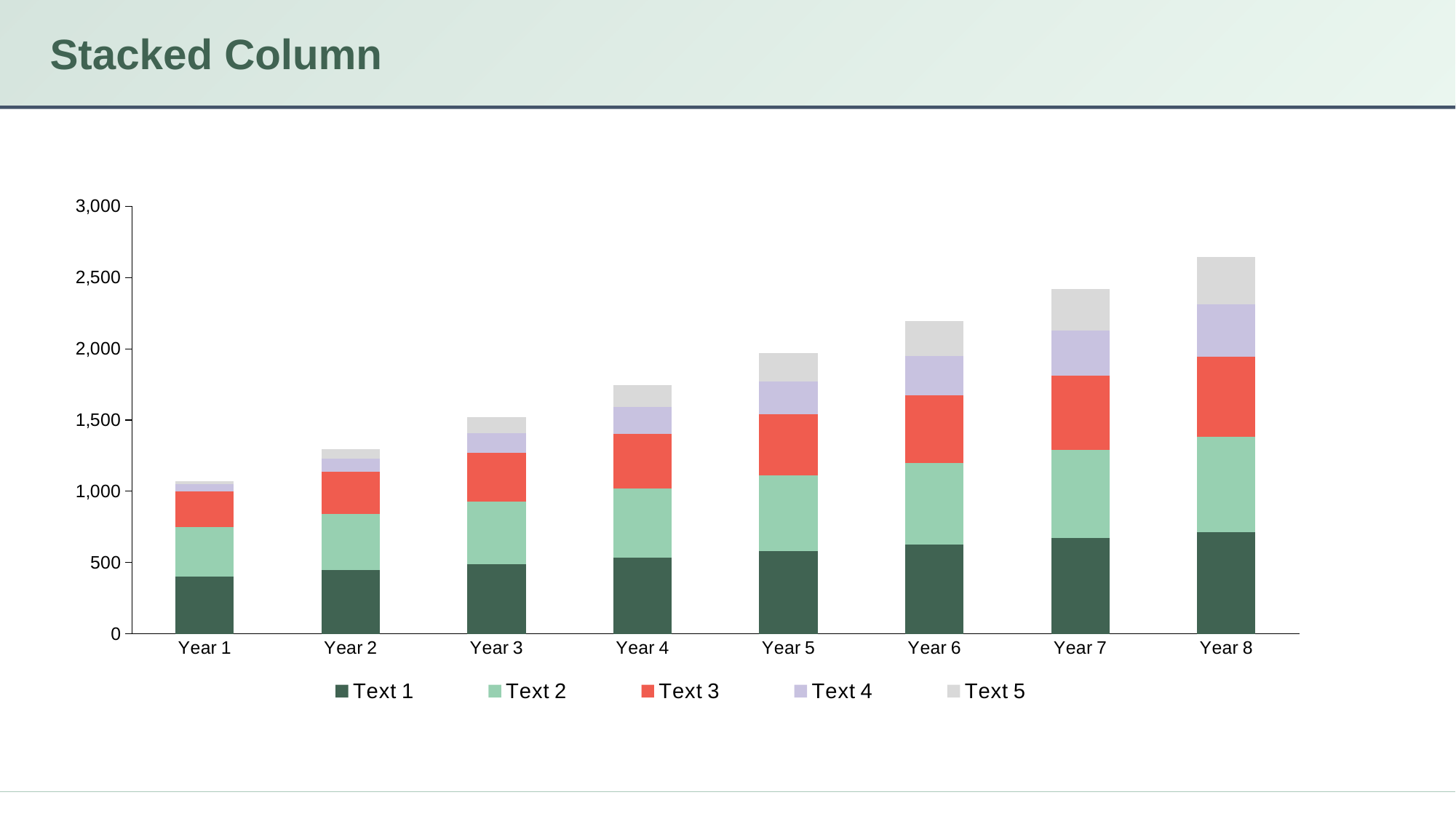
How many series does the legend list? 5 Which year has the highest total stacked bar? Year 8 Is the Text 1 value for Year 8 greater or less than 500? greater Is the total stacked bar for Year 1 greater or less than 1,500? less Which year has the lowest total stacked bar? Year 1 What is the title of the chart on the slide? Stacked Column Do the total bar heights rise or fall from Year 1 to Year 8? rise Is the total stacked bar for Year 6 greater or less than 2,000? greater How many categories are shown on the x axis? 8 What kind of chart is shown on the slide? bar chart Which has the larger total stacked bar, Year 3 or Year 7? Year 7